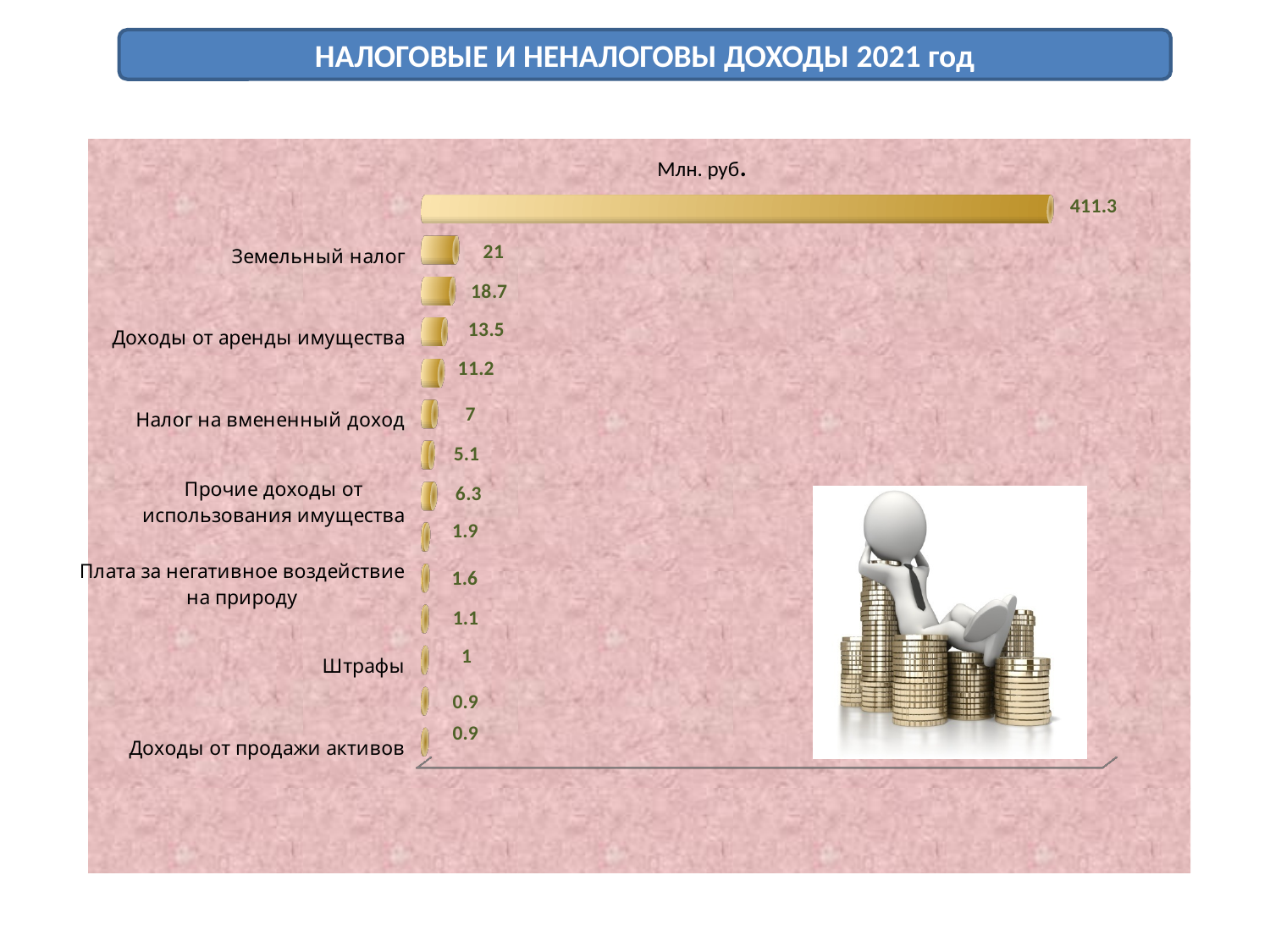
How many bars are plotted on the chart? 14 What is the difference between the values for Плата за негативное воздействие на природу and Штрафы? 0.6 What is the value for Доходы от аренды имущества? 13.5 What is the value for Доходы от продажи активов? 0.9 What is the value for Налог на вмененный доход? 7 What is the value for Штрафы? 1 What is the largest value shown on the chart? 411.3 What kind of chart is shown on the slide? Bar chart What is the value for Земельный налог? 21 Which is larger, the value for Налог на вмененный доход or the value for Прочие доходы от использования имущества? Налог на вмененный доход What unit is given in the chart title? Млн. руб. What is the difference between the values for Земельный налог and Доходы от аренды имущества? 7.5